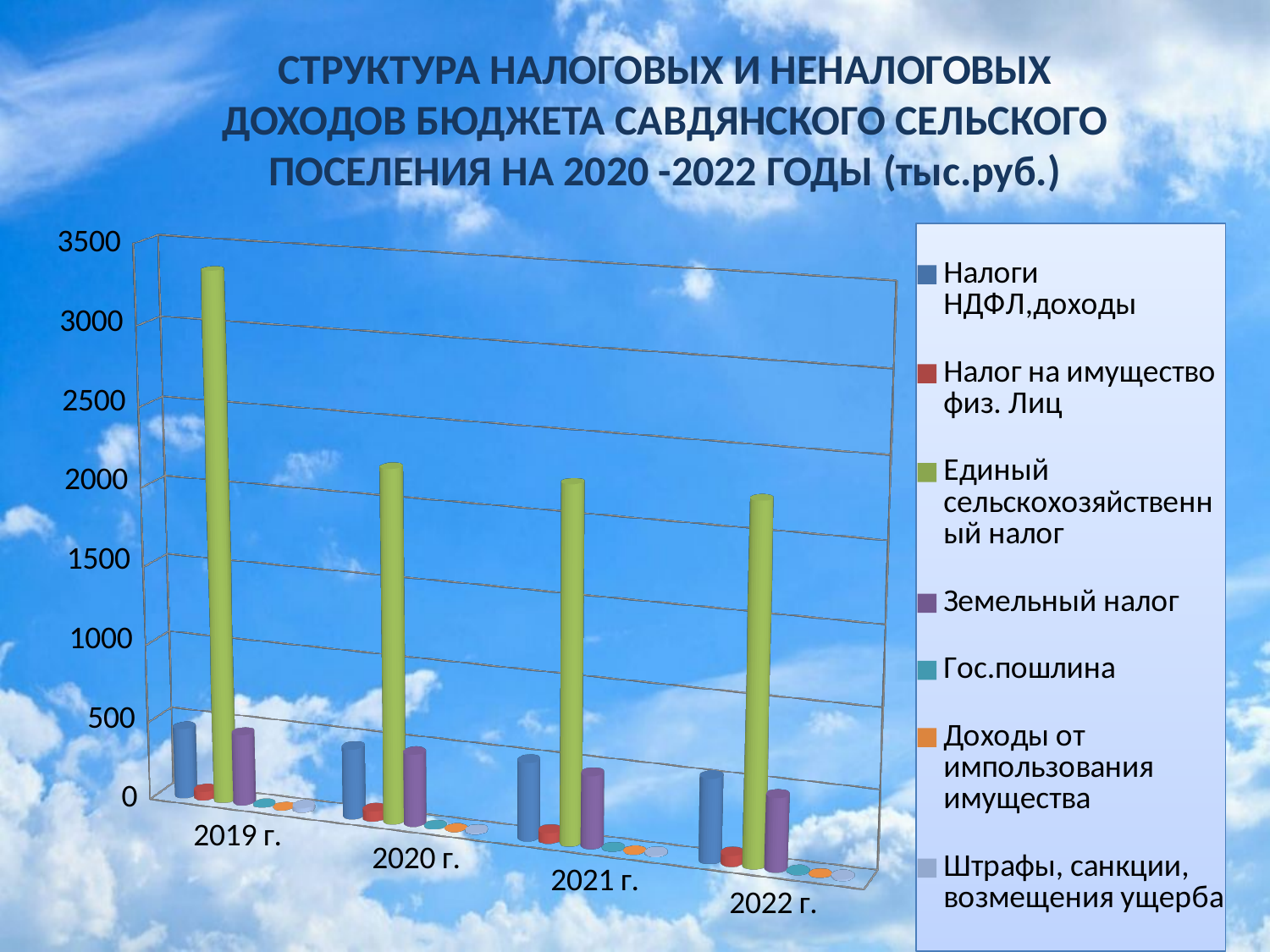
Which is larger: Единый сельскохозяйственный налог in 2019 or in 2022? 2019 Which series has the highest value in 2022? Единый сельскохозяйственный налог How many series does the legend list? 7 Which series is shown in green in the legend? Единый сельскохозяйственный налог Do the values for Единый сельскохозяйственный налог rise or fall from 2019 to 2022? fall What kind of chart is shown on the slide? bar chart Which series has the highest value in 2019? Единый сельскохозяйственный налог Is the value for Единый сельскохозяйственный налог in 2019 greater or less than 3000? greater How many years (categories) are shown on the x axis of the chart? 4